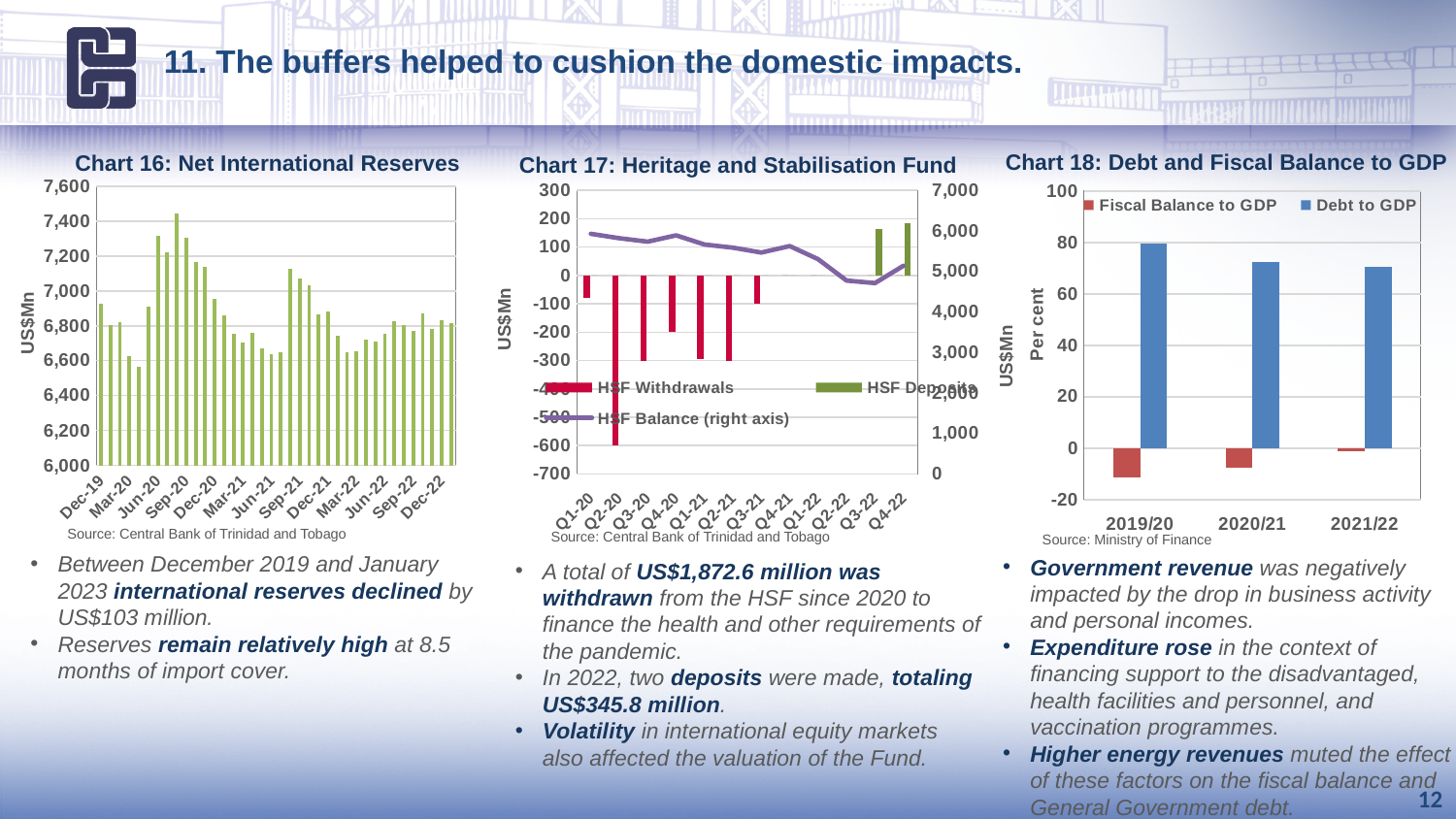
What kind of chart is Chart 16: Net International Reserves? bar chart In Chart 18: Debt and Fiscal Balance to GDP, does Debt to GDP rise or fall from 2019/20 to 2021/22? fall What kind of chart is Chart 18: Debt and Fiscal Balance to GDP? bar chart In Chart 16: Net International Reserves, is the value for Dec-22 greater or less than 7,000? less In Chart 18: Debt and Fiscal Balance to GDP, which fiscal year has the highest Debt to GDP? 2019/20 In Chart 18: Debt and Fiscal Balance to GDP, which is larger, Debt to GDP in 2019/20 or in 2021/22? 2019/20 In Chart 17: Heritage and Stabilisation Fund, how many quarters are shown on the x axis? 12 In Chart 18: Debt and Fiscal Balance to GDP, how many fiscal years are shown on the x axis? 3 In Chart 18: Debt and Fiscal Balance to GDP, is the Debt to GDP value for 2021/22 greater or less than 60? greater In Chart 17: Heritage and Stabilisation Fund, which series is plotted on the right axis? HSF Balance In Chart 18: Debt and Fiscal Balance to GDP, how many series does the legend list? 2 In Chart 17: Heritage and Stabilisation Fund, how many series does the legend list? 3